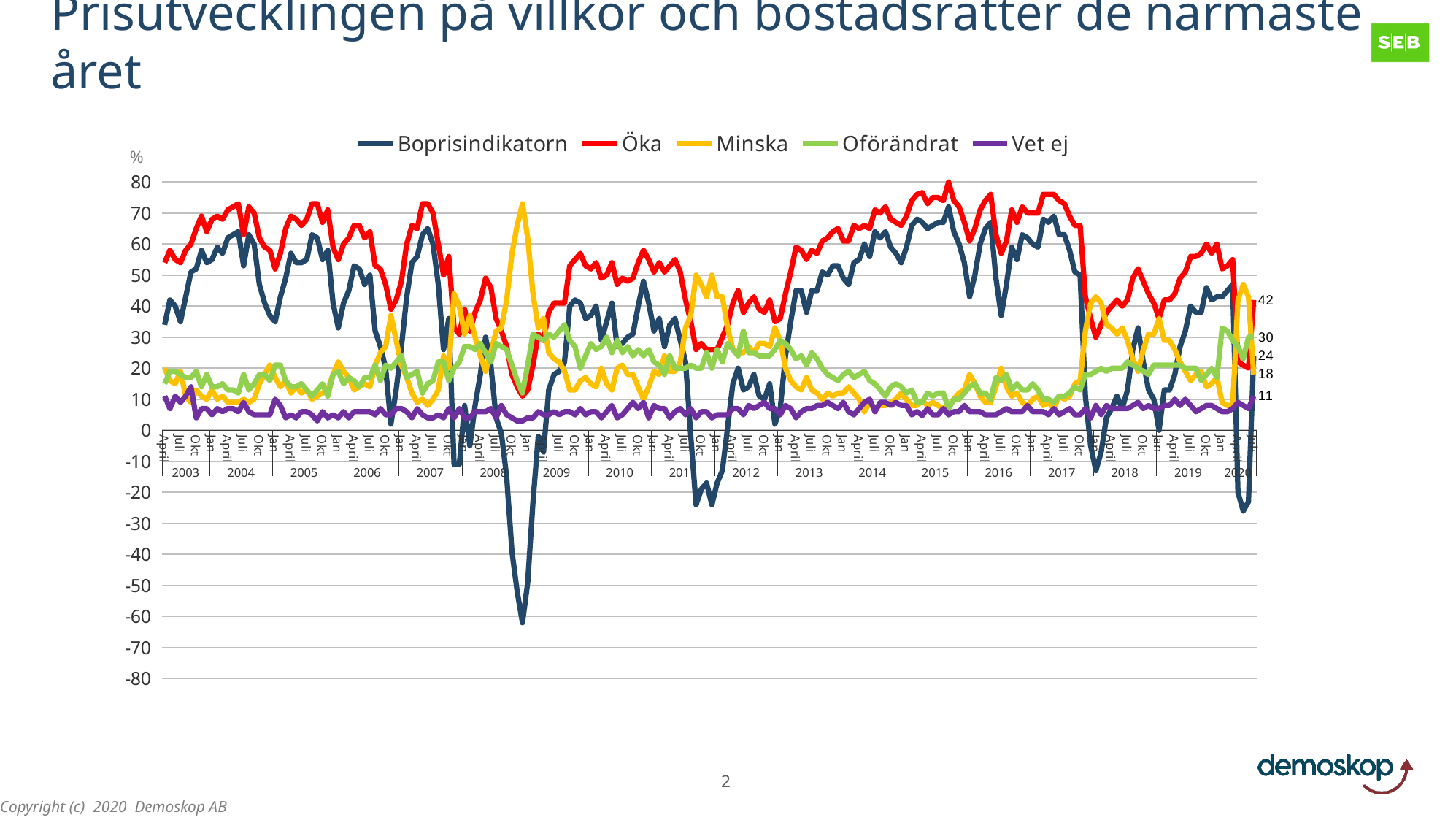
At the end of the series, which is larger: Öka or Minska? Öka What type of chart is shown on the slide? line chart What is the latest labelled value for the Öka series? 42 What is the latest labelled value for the Minska series? 18 What is the difference between the latest labelled values of Öka and Minska? 24 What is the latest labelled value for the Vet ej series? 11 What is the latest labelled value for the Boprisindikatorn series? 24 Is the lowest value reached by Boprisindikatorn (around 2008–2009) greater or less than -50? less What is the latest labelled value for the Oförändrat series? 30 What unit is shown on the y axis? % How many series does the legend list? 5 Is the highest value reached by the Öka series greater or less than 70? greater